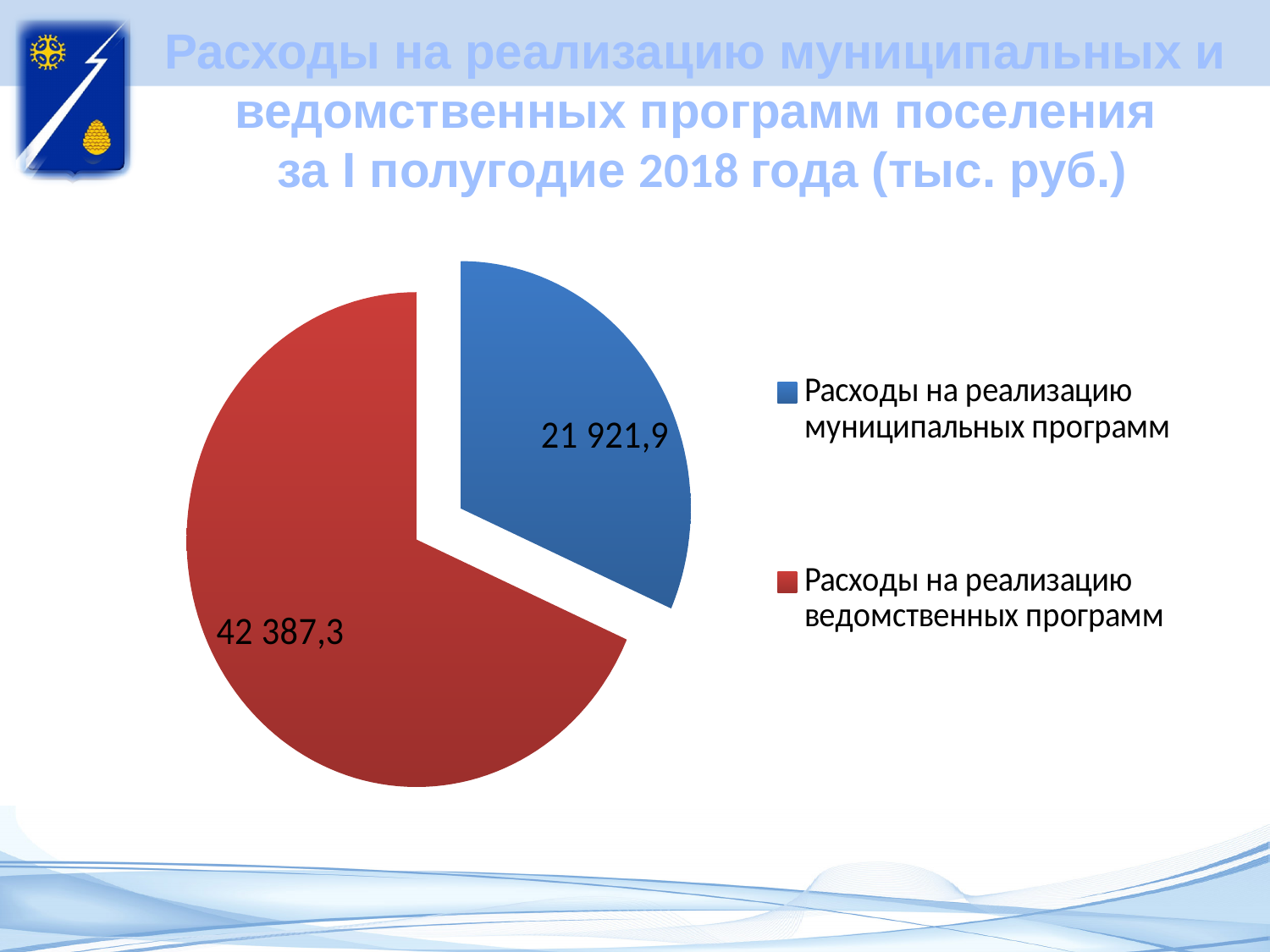
What colour is the slice for "Расходы на реализацию муниципальных программ"? Blue Which category has the smallest slice of the pie? Расходы на реализацию муниципальных программ What type of chart is shown on the slide? Pie chart What is the difference between the value for ведомственных программ and the value for муниципальных программ? 20 465,4 Which category has the largest slice of the pie? Расходы на реализацию ведомственных программ What is the value for "Расходы на реализацию ведомственных программ"? 42 387,3 How many slices does the pie chart have? 2 Which is larger: the value for муниципальных программ or the value for ведомственных программ? Расходы на реализацию ведомственных программ What is the total of the two values shown in the pie chart? 64 309,2 What is the value for "Расходы на реализацию муниципальных программ"? 21 921,9 In what units are the values in the chart expressed, according to the slide title? тыс. руб.